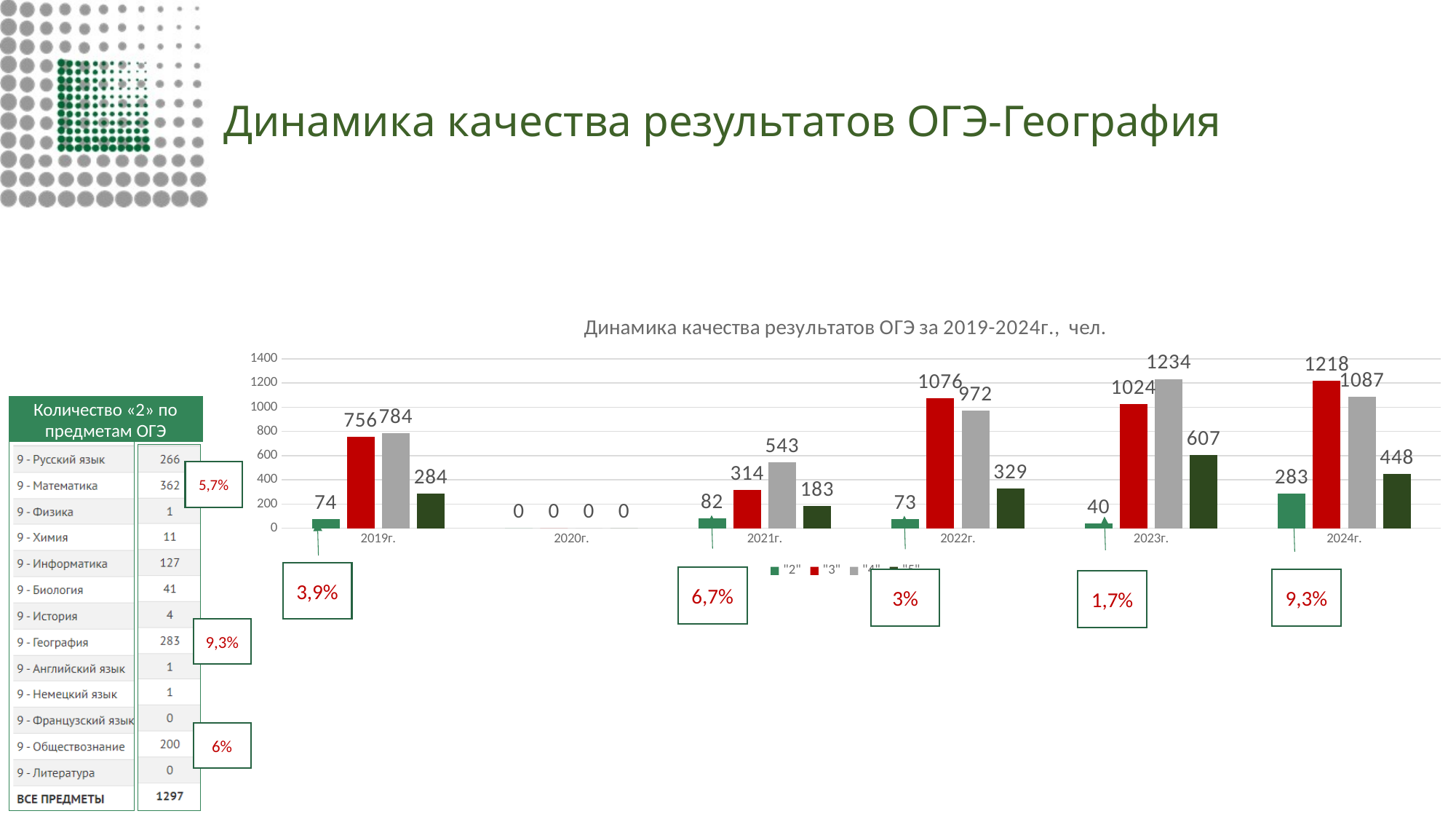
How many series does the chart legend list? 4 What type of chart is shown on the slide? Bar chart What is the difference between the series "3" value in 2024г. and in 2023г.? 194 Which is larger in 2019г.: the value for series "3" or series "4"? series "4" (784) How many years are shown on the x axis of the chart? 6 What is the value for series "4" in 2021г. on the chart? 543 Which year has the lowest value for series "2" among the years with non-zero values? 2023г. What is the value for series "5" in 2023г. on the chart? 607 What is the title of the chart on the slide? Динамика качества результатов ОГЭ за 2019-2024г., чел. In which year does series "4" reach its highest value on the chart? 2023г. What is the value for series "3" in 2022г. on the chart? 1076 What is the value for series "2" in 2024г. on the chart? 283